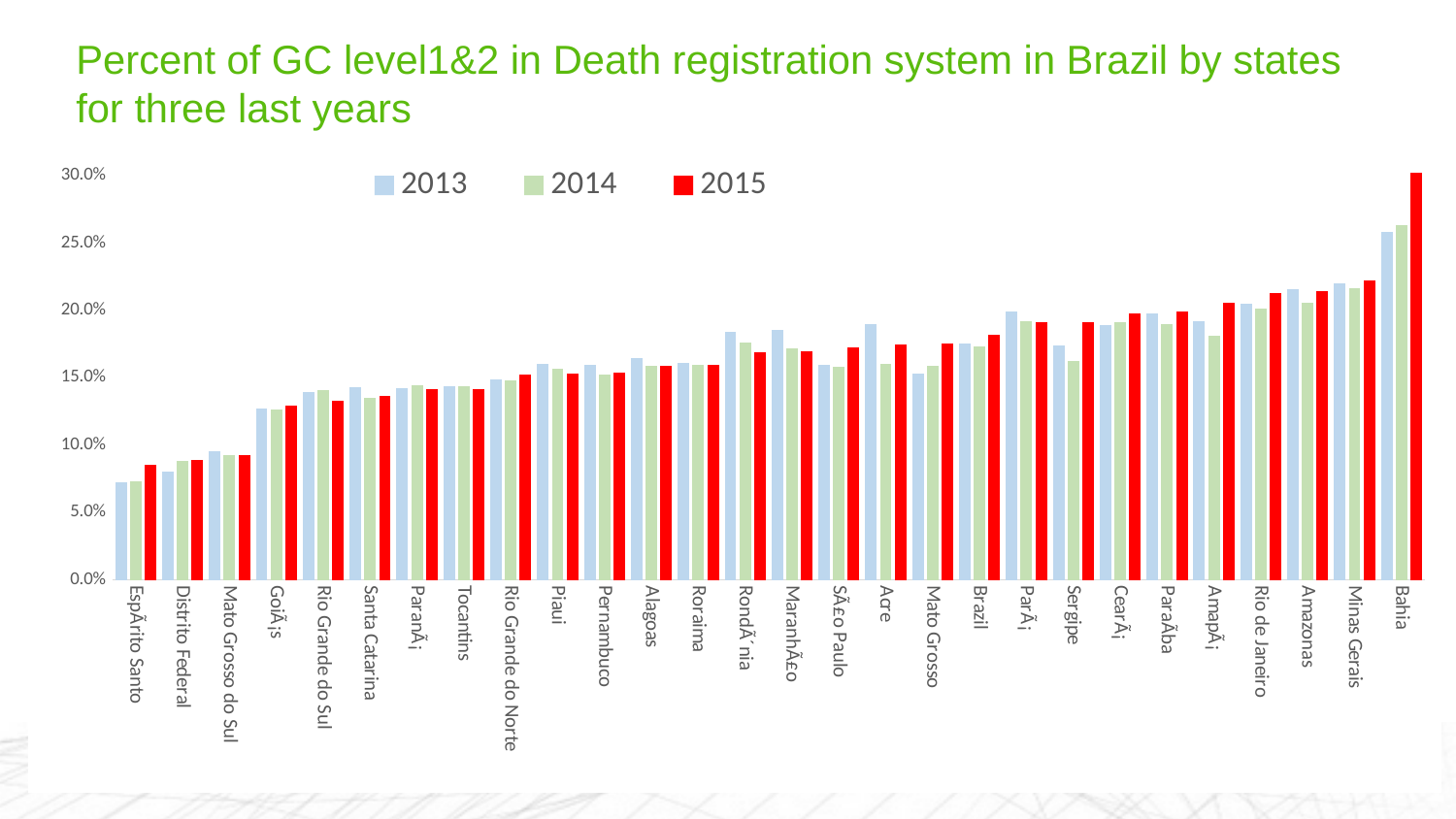
How many series does the legend list? 3 Is the 2015 value for Minas Gerais greater or less than 20.0%? greater How many categories (states plus Brazil) are shown on the x axis? 28 Is the 2013 value for Acre greater or less than 15.0%? greater Is the 2015 value for Bahia greater or less than 25.0%? greater Which category has the lowest 2013 value? Espírito Santo For Acre, which is larger: the 2013 value or the 2014 value? 2013 Do the 2015 values generally rise or fall moving from left to right along the x axis? rise What kind of chart is shown on the slide? Bar chart Which years are listed in the legend? 2013, 2014, 2015 Which category has the highest 2015 value? Bahia